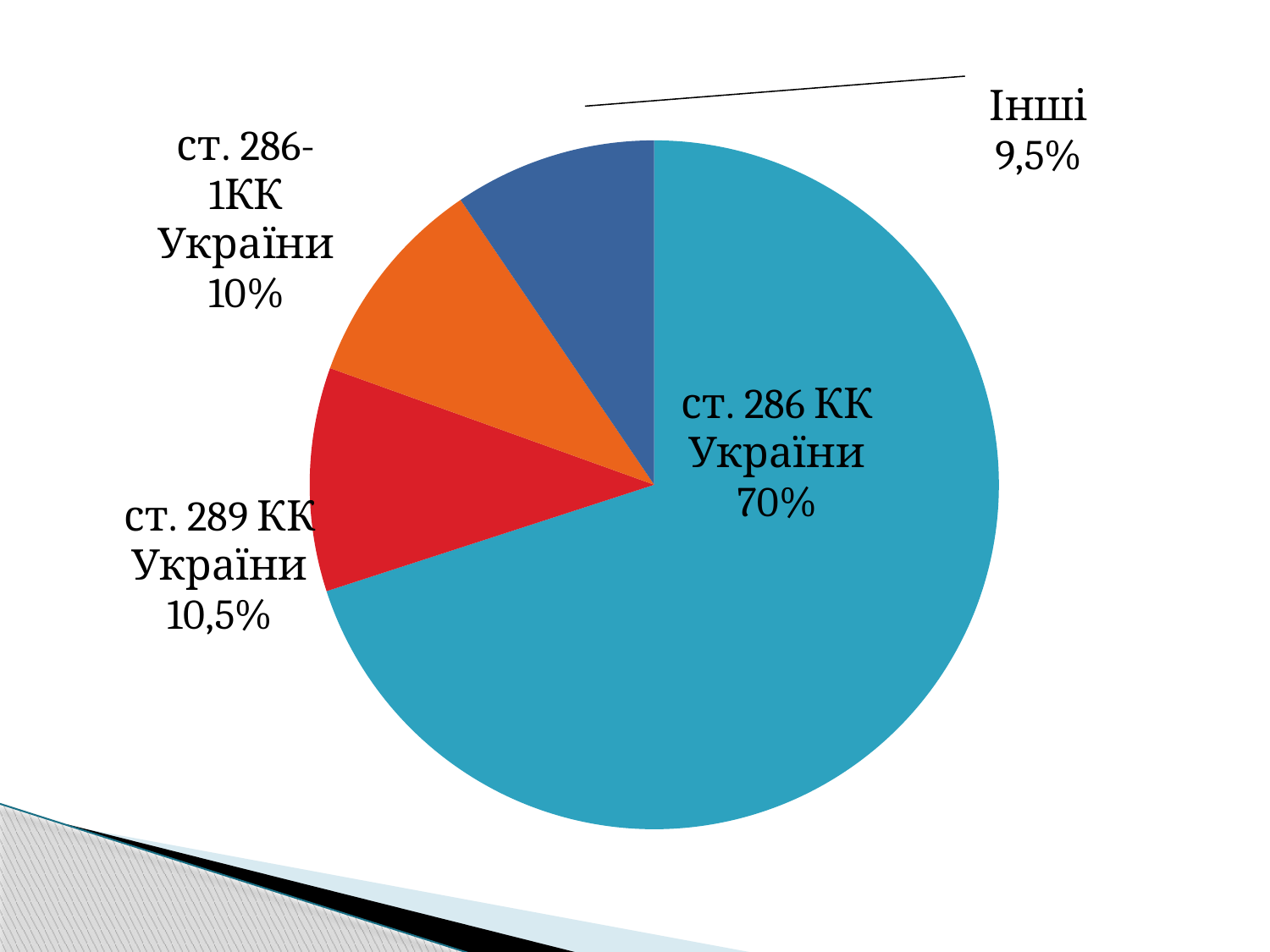
Which is larger, the share for ст. 289 КК України or the share for ст. 286-1 КК України? ст. 289 КК України What is the value shown for ст. 286-1 КК України? 10% What colour is the slice for ст. 289 КК України? red What kind of chart is shown on the slide? pie chart What is the difference between the shares of ст. 286 КК України and ст. 289 КК України? 59,5% What share of the pie does ст. 286 КК України have? 70% Which slice of the pie is the smallest? Інші What is the difference between the shares of ст. 286-1 КК України and Інші? 0,5% What is the value shown for ст. 289 КК України? 10,5% What is the value shown for the Інші slice? 9,5% Which slice of the pie is the largest? ст. 286 КК України How many slices does the pie chart have? 4